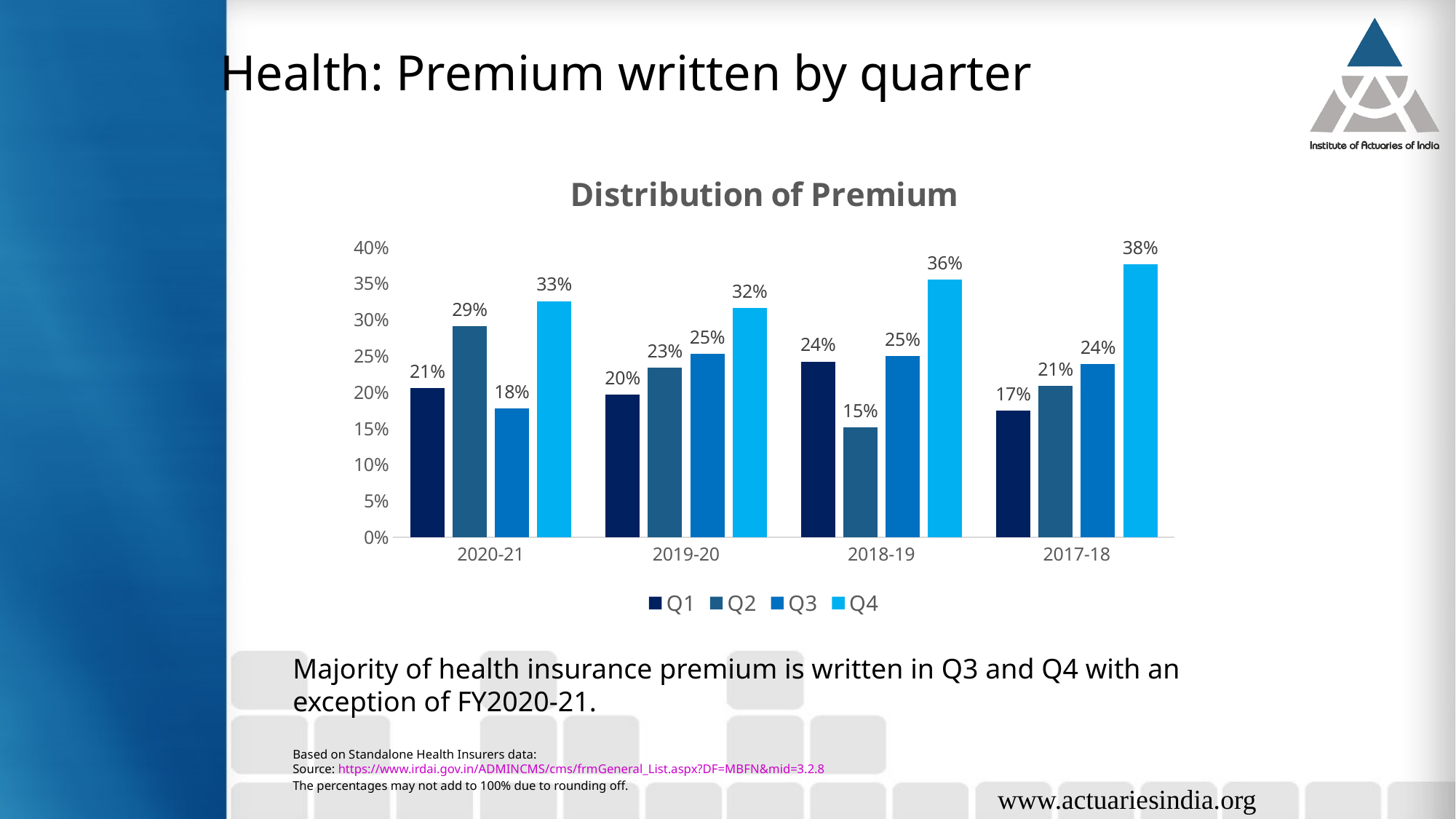
Which year has the highest Q4 value in the Distribution of Premium chart? 2017-18 In the Distribution of Premium chart, which is larger for 2020-21: Q2 or Q3? Q2 How many years are shown on the x axis of the Distribution of Premium chart? 4 What is the Q3 value for 2018-19 in the Distribution of Premium chart? 25% What is the title of the chart on the slide? Distribution of Premium Which quarter has the lowest value for 2018-19 in the Distribution of Premium chart? Q2 What is the Q4 value for 2017-18 in the Distribution of Premium chart? 38% What kind of chart is the Distribution of Premium chart? Bar chart How many series does the legend of the Distribution of Premium chart list? 4 What is the difference between the Q4 and Q1 values for 2019-20 in the Distribution of Premium chart? 12% What is the Q2 value for 2020-21 in the Distribution of Premium chart? 29% What is the Q1 value for 2017-18 in the Distribution of Premium chart? 17%